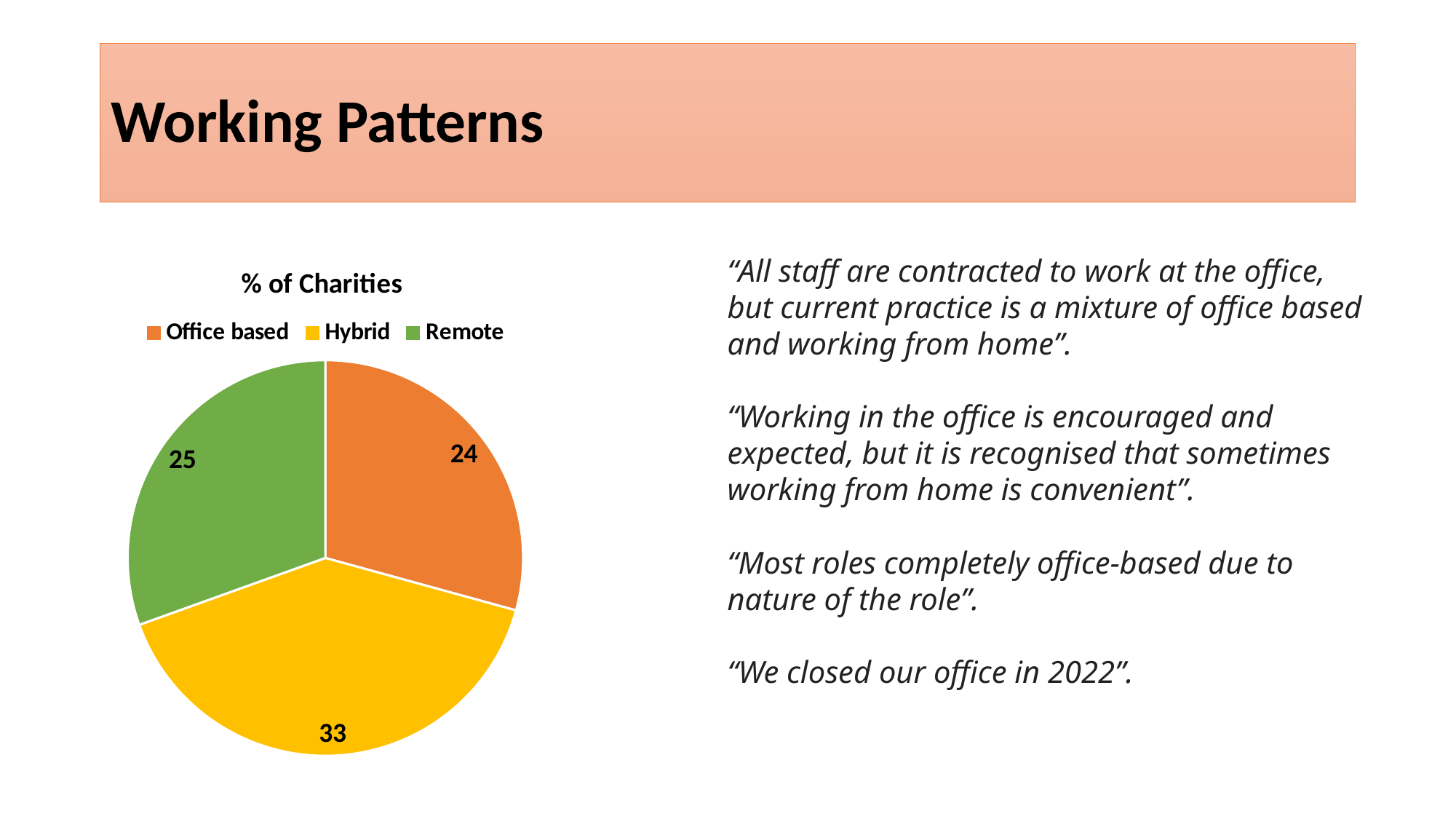
What is the value for Hybrid in the pie chart? 33 What is the value for Remote in the pie chart? 25 Which category has the smallest slice of the pie? Office based What is the difference between the Hybrid value and the Remote value? 8 What is the difference between the Hybrid value and the Office based value? 9 Which category has the largest slice of the pie? Hybrid Which colour represents Remote in the pie chart? Green How many categories does the pie chart show? 3 What is the title of the chart? % of Charities What type of chart is shown on the slide? Pie chart What is the value for Office based in the pie chart? 24 Which is larger, the value for Hybrid or the value for Office based? Hybrid